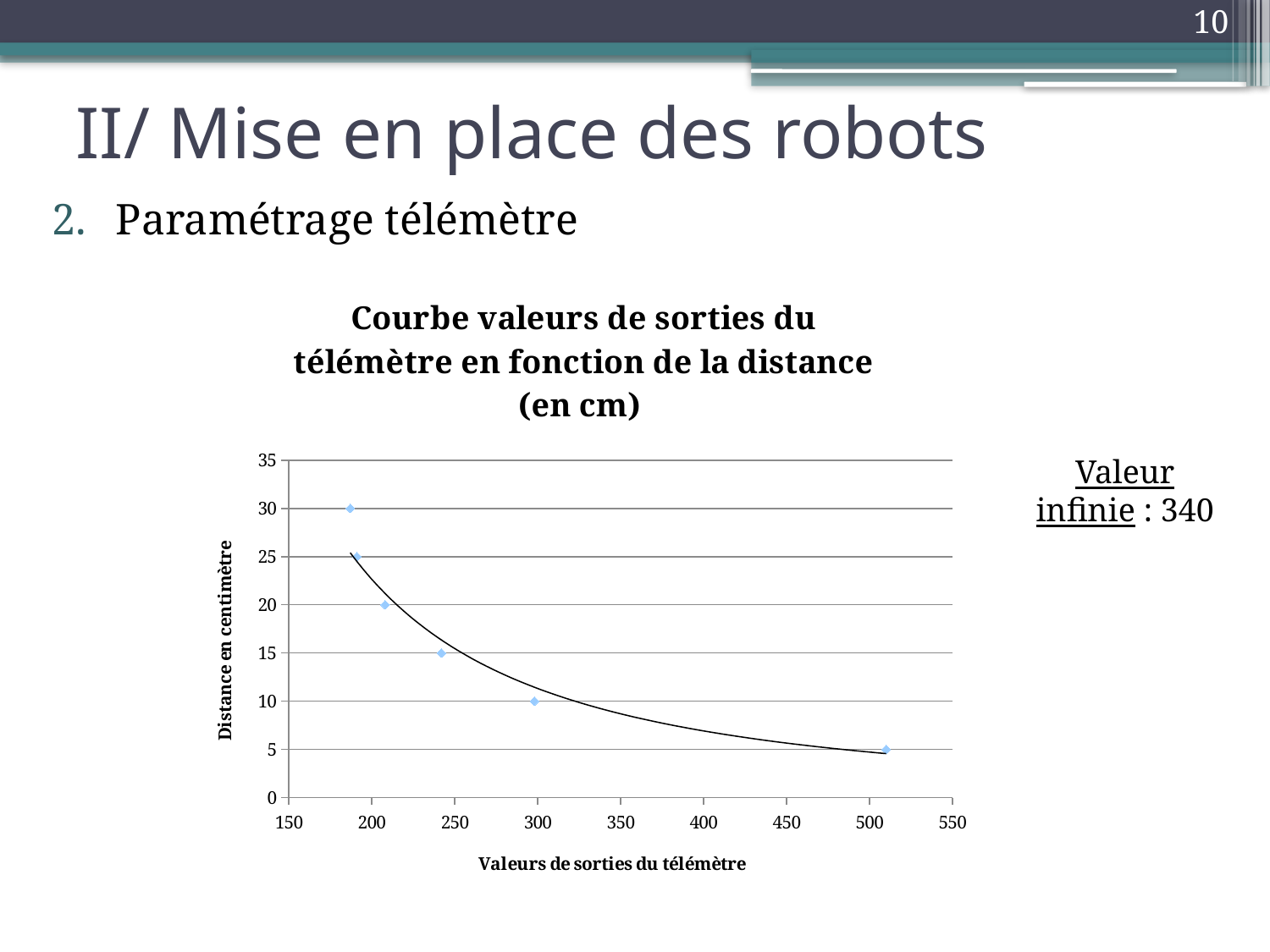
What is the title of the x axis? Valeurs de sorties du télémètre What is the highest distance value (in cm) among the plotted points? 30 What is the distance (in cm) of the point with the largest télémètre output value? 5 Which point has a larger télémètre output value: the one at 15 cm or the one at 10 cm? the one at 10 cm Is the télémètre output value for the point at 5 cm greater or less than 450? greater What is the title of the y axis? Distance en centimètre As the télémètre output value increases along the x axis, does the distance rise or fall? fall Is the télémètre output value for the point at 10 cm greater or less than 350? less Is the télémètre output value for the point at 30 cm greater or less than 200? less What is the lowest distance value (in cm) among the plotted points? 5 How many data points are plotted on the chart? 6 What kind of chart is shown on the slide? scatter chart